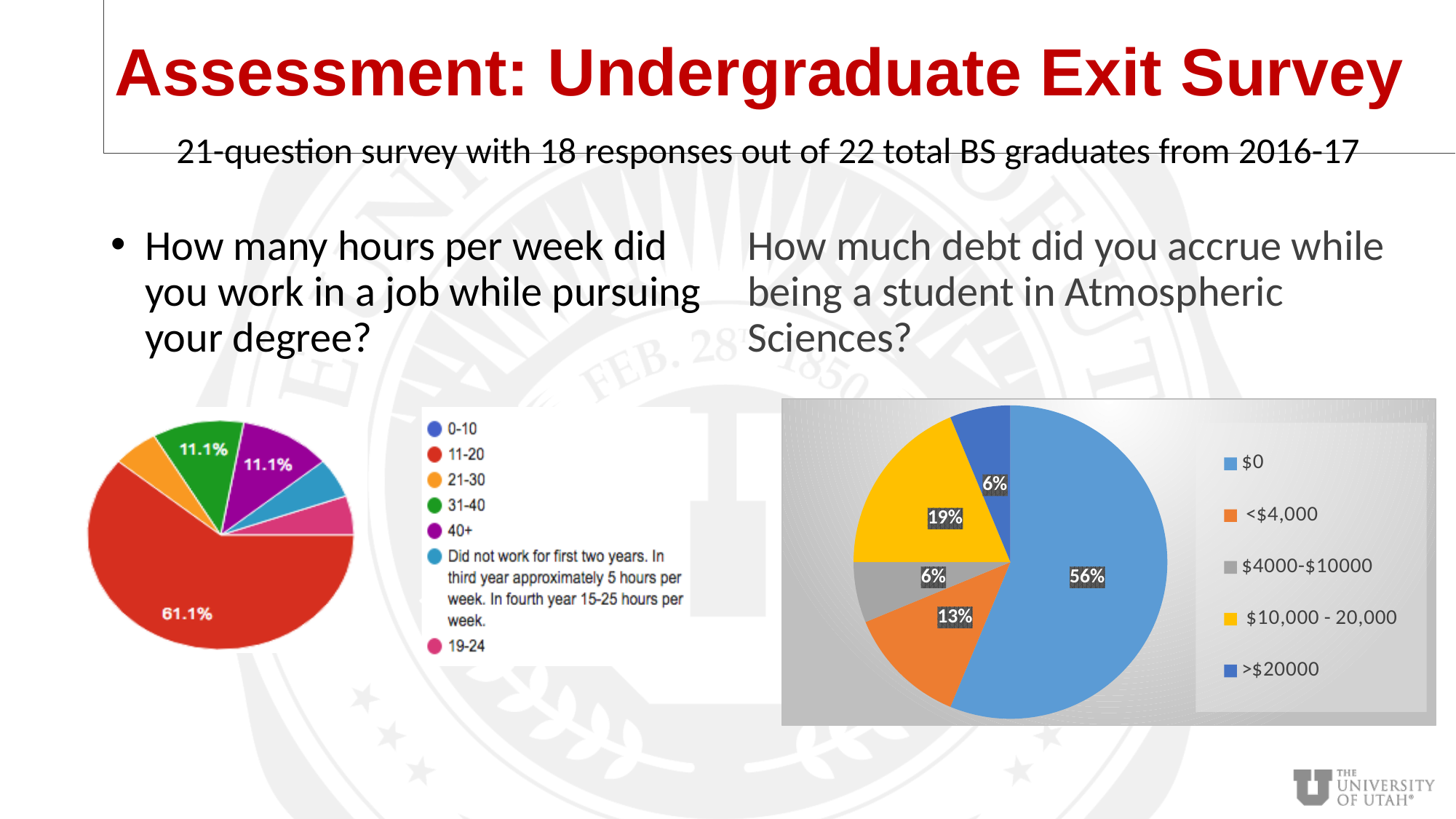
What type of chart is used on the left to show hours worked per week? Pie chart In the pie chart on the right about debt accrued, what is the difference between the $0 share and the $10,000 - 20,000 share? 37 percentage points In the pie chart on the right about debt accrued, which debt category has the largest share? $0 In the pie chart on the left about hours worked per week, what share of respondents worked 11-20 hours? 61.1% In the pie chart on the left about hours worked per week, which category has the largest share? 11-20 How many categories does the legend of the pie chart on the right about debt accrued list? 5 In the pie chart on the left about hours worked per week, what share of respondents worked 40+ hours? 11.1% In the pie chart on the right about debt accrued, what share of respondents reported $10,000 - 20,000 in debt? 19% In the pie chart on the right about debt accrued, what share of respondents reported $0 debt? 56% In the pie chart on the right about debt accrued, which is larger: the share for <$4,000 or the share for $4000-$10000? <$4,000 In the pie chart on the right about debt accrued, what share of respondents reported <$4,000 in debt? 13% In the pie chart on the right about debt accrued, what share of respondents reported >$20000 in debt? 6%